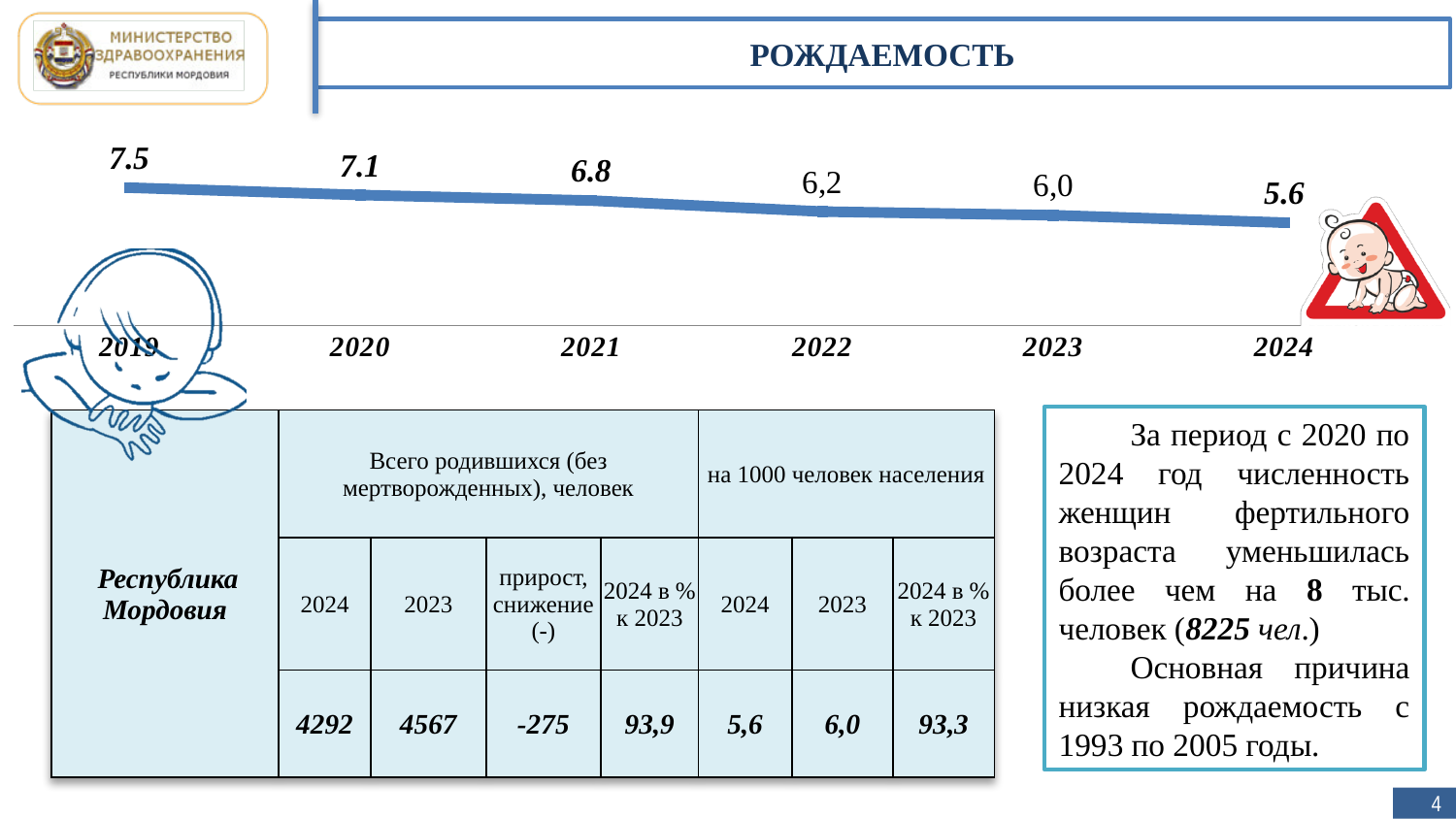
Which year has the highest birth rate on the chart? 2019 What is the difference between the 2020 and 2021 birth rate values? 0.3 What is the birth rate value shown for 2019? 7.5 What type of chart is used to show the birth rate? line chart Which year has a higher birth rate, 2020 or 2023? 2020 Which year has the lowest birth rate on the chart? 2024 What is the birth rate value shown for 2021? 6.8 What is the birth rate value shown for 2024? 5.6 Does the birth rate rise or fall from 2019 to 2024? fall What is the birth rate value shown for 2022? 6,2 How many years are plotted on the birth rate chart? 6 By how much did the birth rate fall from 2019 to 2024? 1.9